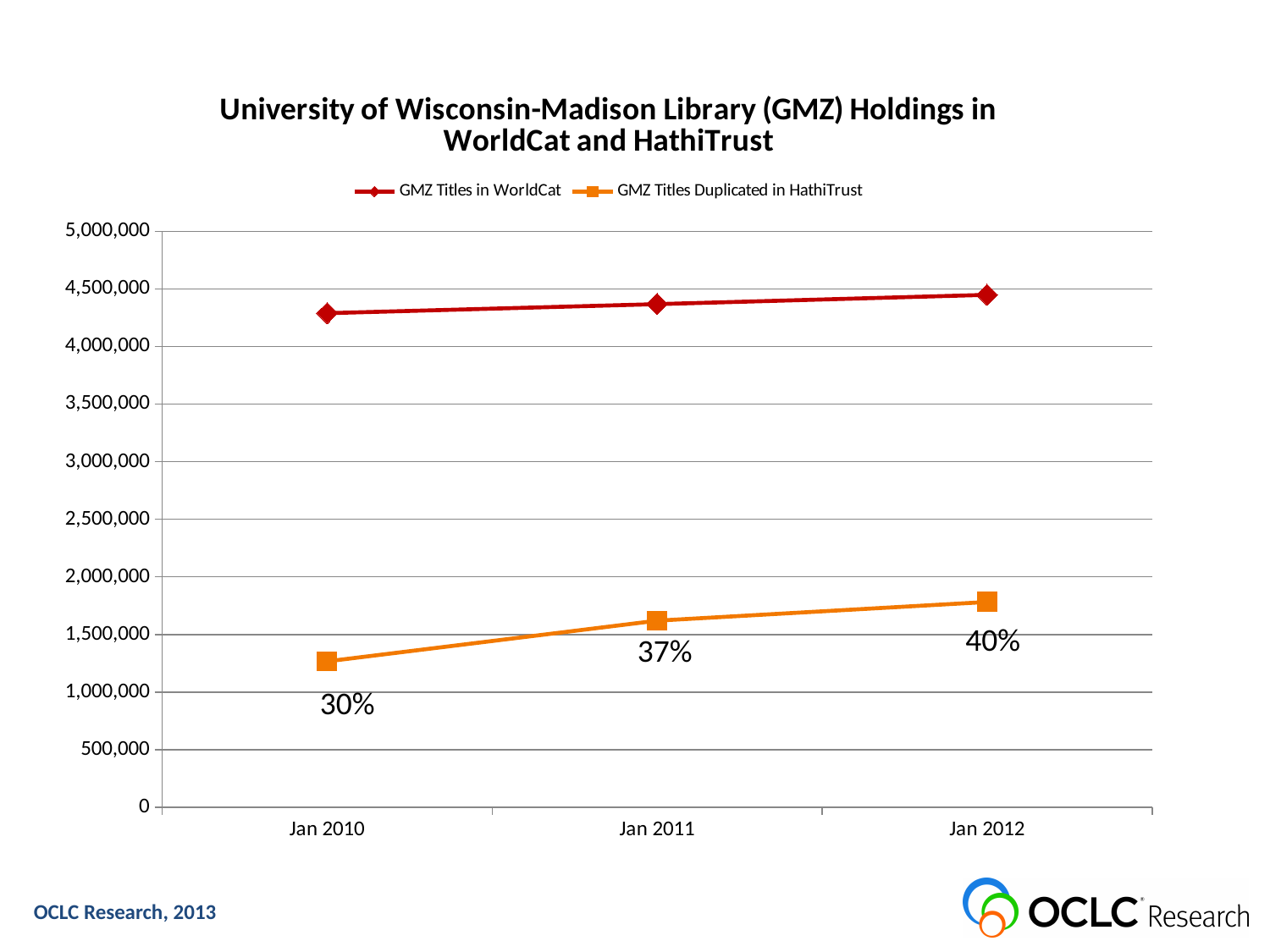
How many series does the legend list? 2 What percentage label is shown for GMZ Titles Duplicated in HathiTrust at Jan 2010? 30% Which series has the larger value at Jan 2011, GMZ Titles in WorldCat or GMZ Titles Duplicated in HathiTrust? GMZ Titles in WorldCat At which time point is the value for GMZ Titles Duplicated in HathiTrust highest? Jan 2012 Is the value for GMZ Titles Duplicated in HathiTrust at Jan 2012 greater or less than 2,000,000? less What kind of chart is shown on the slide? line chart Do the values for GMZ Titles Duplicated in HathiTrust rise or fall from Jan 2010 to Jan 2012? rise What percentage label is shown for GMZ Titles Duplicated in HathiTrust at Jan 2011? 37% At which time point is the value for GMZ Titles in WorldCat lowest? Jan 2010 What percentage label is shown for GMZ Titles Duplicated in HathiTrust at Jan 2012? 40% Is the value for GMZ Titles in WorldCat at Jan 2010 greater or less than 4,000,000? greater How many time points are plotted along the x axis? 3